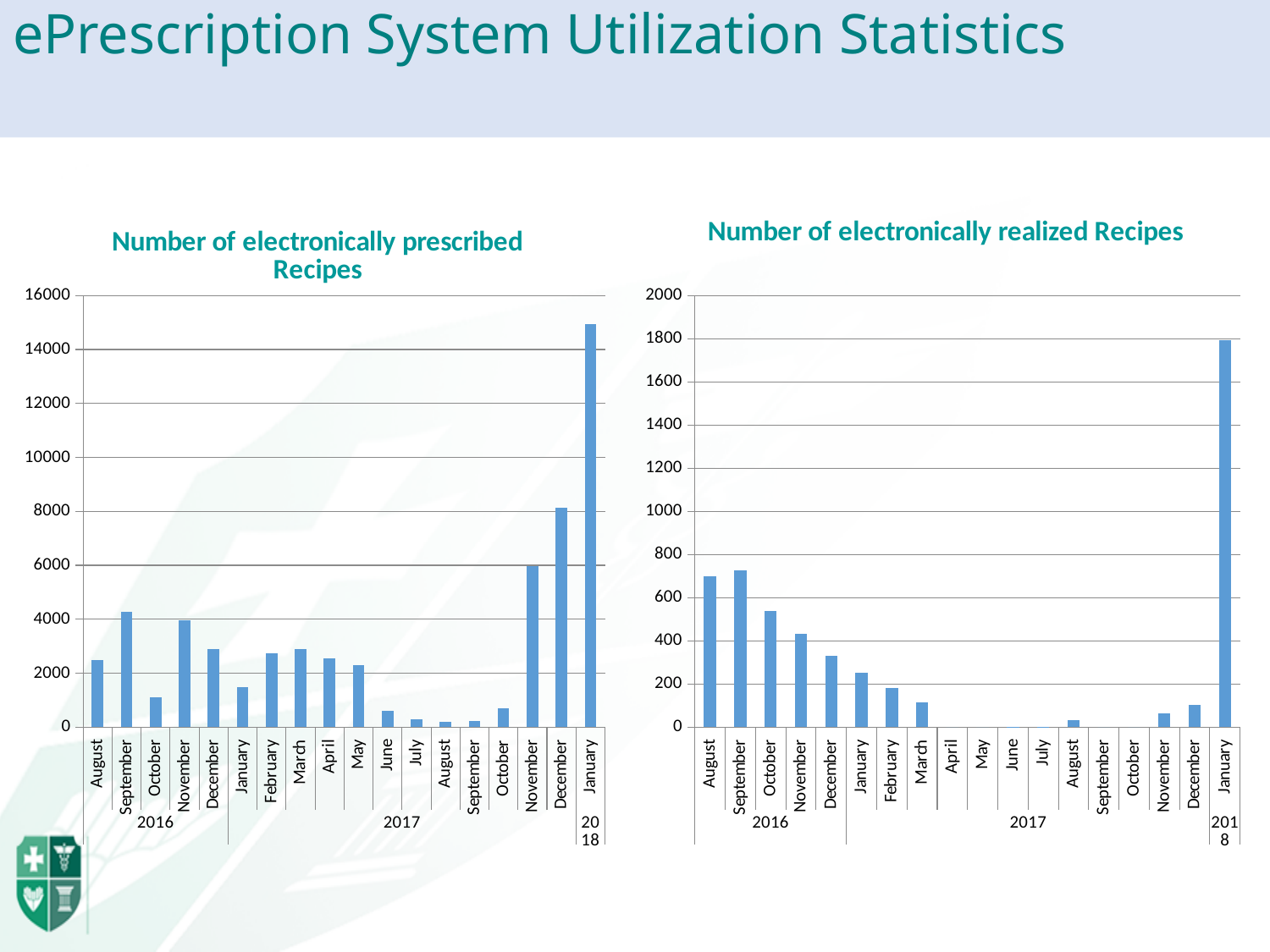
In the 'Number of electronically prescribed Recipes' chart, is the value for October 2016 greater or less than 2000? less In the 'Number of electronically realized Recipes' chart, which month has the highest value? January 2018 In the 'Number of electronically prescribed Recipes' chart, is the value for January 2018 greater or less than 14000? greater How many months are plotted in the 'Number of electronically prescribed Recipes' chart? 18 In the 'Number of electronically realized Recipes' chart, is the value for January 2018 greater or less than 1600? greater In the 'Number of electronically prescribed Recipes' chart, which is larger, the value for September 2016 or the value for December 2016? September 2016 In the 'Number of electronically prescribed Recipes' chart, which month has the highest value? January 2018 In the 'Number of electronically realized Recipes' chart, do the values rise or fall from September 2016 to March 2017? fall What kind of chart is the 'Number of electronically prescribed Recipes' chart on the left? bar chart In the 'Number of electronically realized Recipes' chart, which is larger, the value for October 2016 or the value for November 2016? October 2016